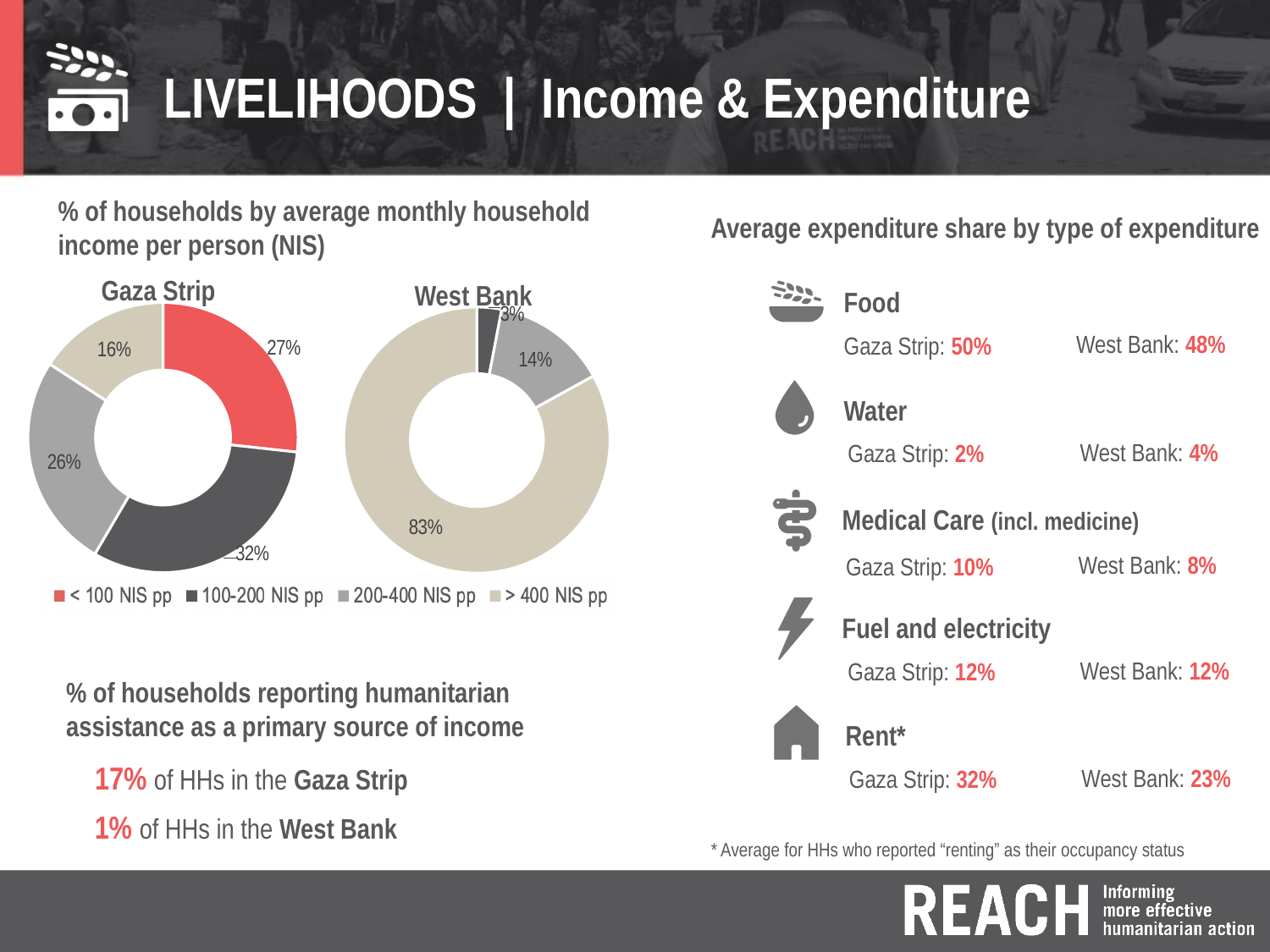
In the Gaza Strip donut chart, which income category has the largest share of households? 100-200 NIS pp In the Gaza Strip donut chart, what percentage of households have an average monthly income of < 100 NIS pp? 27% What type of chart is used to show the % of households by average monthly household income per person? Donut (pie) chart In the West Bank donut chart, what percentage of households fall in the > 400 NIS pp category? 83% In the West Bank donut chart, which income category has the largest share of households? > 400 NIS pp In the Gaza Strip donut chart, which income category has the smallest share of households? > 400 NIS pp Which chart shows a larger share of households in the > 400 NIS pp category, Gaza Strip or West Bank? West Bank In the Gaza Strip donut chart, what percentage of households fall in the > 400 NIS pp category? 16% In the West Bank donut chart, what percentage of households fall in the 200-400 NIS pp category? 14% In the Gaza Strip donut chart, what is the difference in percentage points between the 100-200 NIS pp and 200-400 NIS pp categories? 6 percentage points How many income categories does the legend of the income donut charts list? 4 In the Gaza Strip donut chart, what percentage of households fall in the 100-200 NIS pp category? 32%